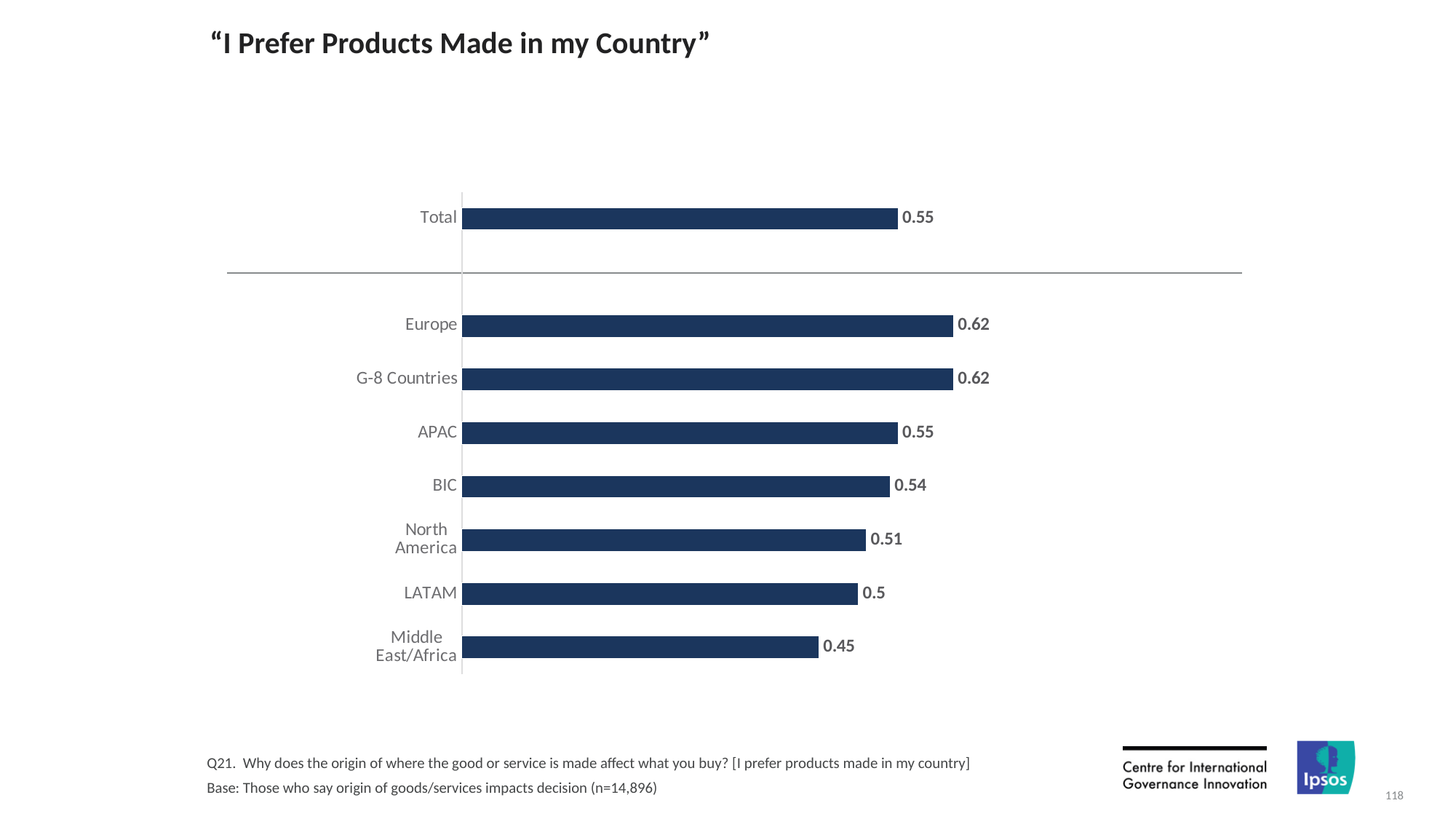
What is the value for the Total bar? 0.55 What is the value for Middle East/Africa? 0.45 How many bars are plotted on the chart, including Total? 8 What kind of chart is shown on the slide? Bar chart What is the value for BIC? 0.54 What is the difference between the values for APAC and Middle East/Africa? 0.1 What is the title of the chart? "I Prefer Products Made in my Country" Which is larger, the value for Europe or the value for LATAM? Europe What is the value for Europe? 0.62 Which category has the lowest value? Middle East/Africa What is the difference between the values for G-8 Countries and North America? 0.11 What is the value for LATAM? 0.5